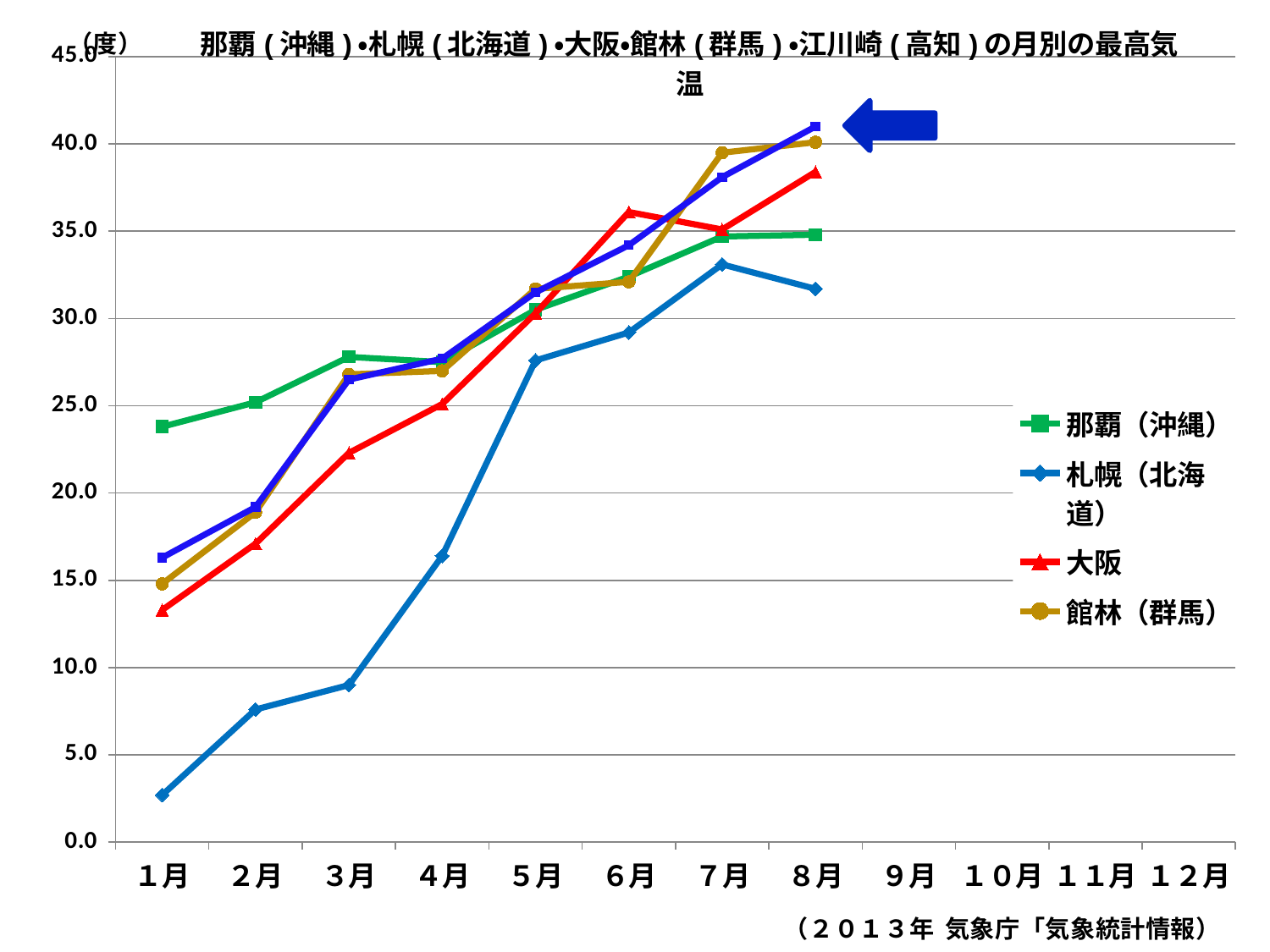
How many series does the legend list? 4 Is the value for 館林（群馬） in 7月 greater or less than 35.0? greater How many month categories are shown on the x axis? 12 Which year is cited in the data source note below the chart? ２０１３年 What kind of chart is shown on the slide? line chart In 8月, which is larger: the value for 大阪 or the value for 札幌（北海道）? 大阪 Does the value for 札幌（北海道） rise or fall from 1月 to 7月? rise Is the value for 大阪 in 8月 greater or less than 35.0? greater Which series has the lowest value in 1月? 札幌（北海道） Is the value for 那覇（沖縄） in 1月 greater or less than 20.0? greater Which series has the highest value in 1月? 那覇（沖縄）